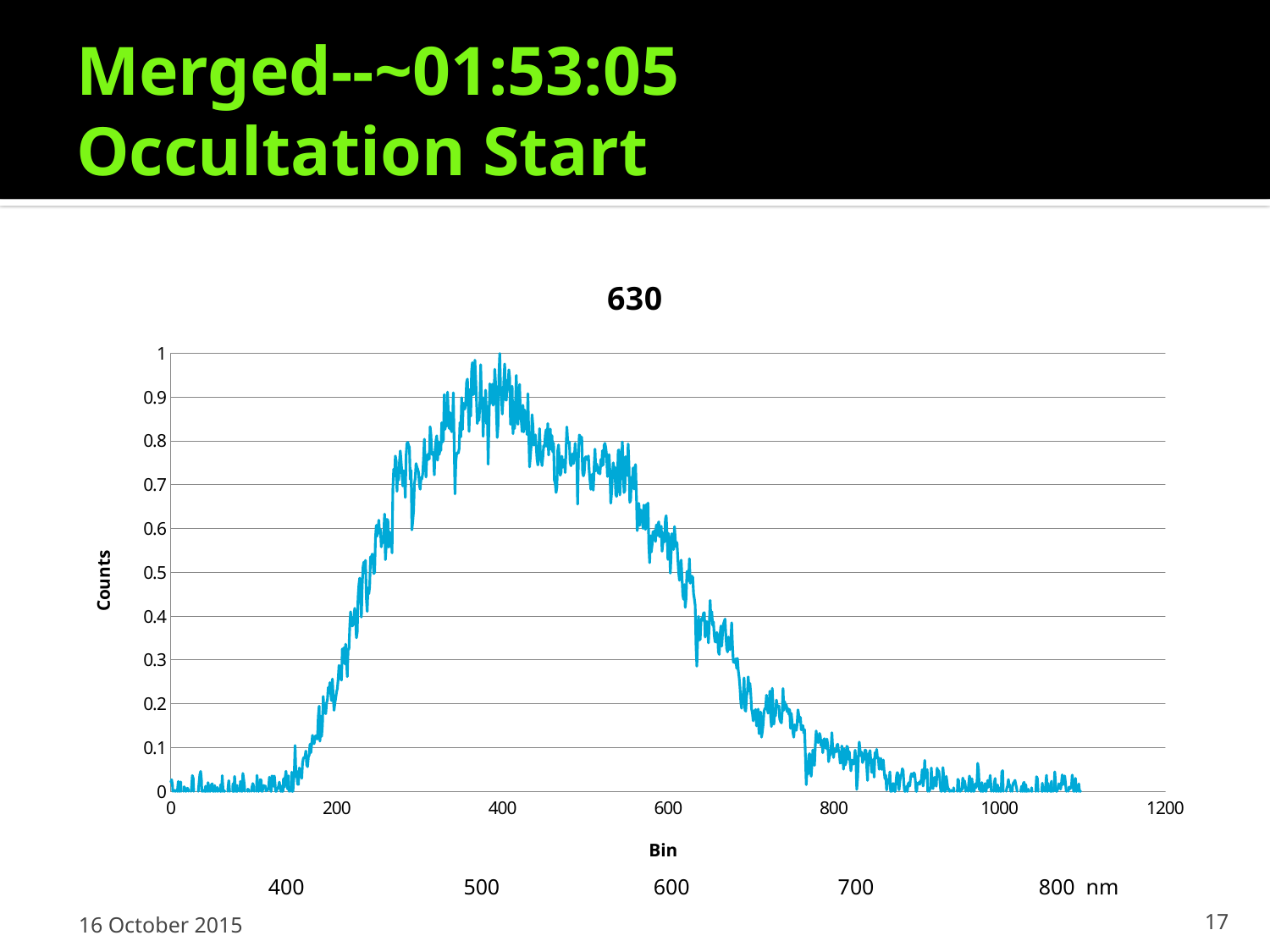
Is the value at bin 100 greater or less than 0.1? less What kind of chart is shown on the slide? line chart Is the value at bin 400 greater or less than 0.5? greater Do the values rise or fall along the x axis between bin 400 and bin 800? fall Is the value at bin 1000 greater or less than 0.1? less What is the title of the chart? 630 Do the values rise or fall along the x axis between bin 200 and bin 400? rise Which is larger, the value at bin 400 or the value at bin 800? bin 400 How many data series are plotted on the chart? 1 What is the label of the x axis of the chart? Bin